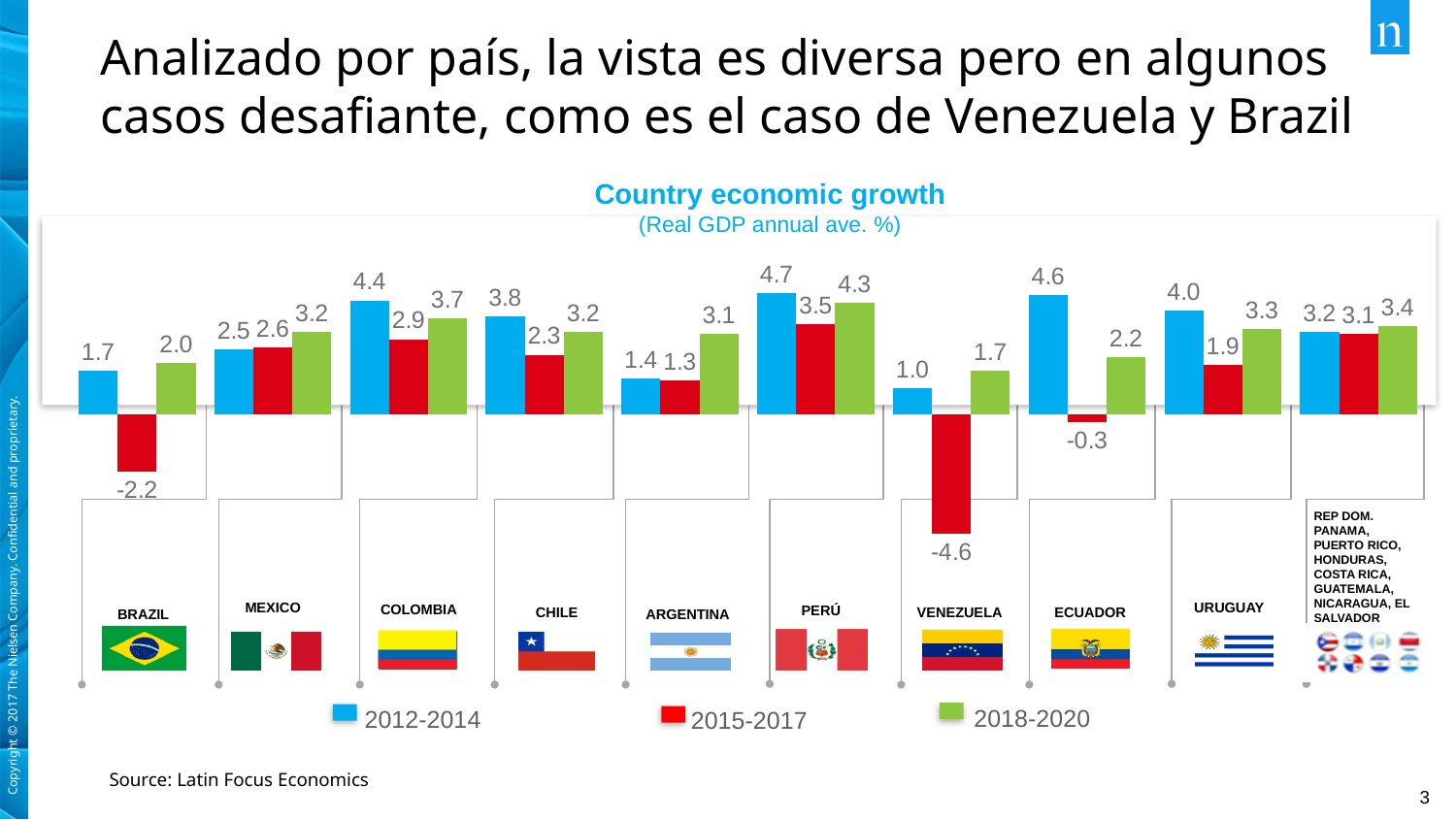
What is the difference between the 2012-2014 and 2015-2017 values for Colombia? 1.5 Which country has the lowest 2015-2017 value? Venezuela Which colour represents the 2018-2020 series in the legend? Green What kind of chart is shown on the slide? Bar chart Which is larger for Chile: the 2012-2014 value or the 2018-2020 value? 2012-2014 What is the 2015-2017 value for Ecuador? -0.3 How many series does the legend list? 3 What is the 2015-2017 value for Brazil? -2.2 What is the 2018-2020 value for Perú? 4.3 Which country has the highest 2012-2014 value? Perú What is the 2012-2014 value for Ecuador? 4.6 What is the title of the chart? Country economic growth